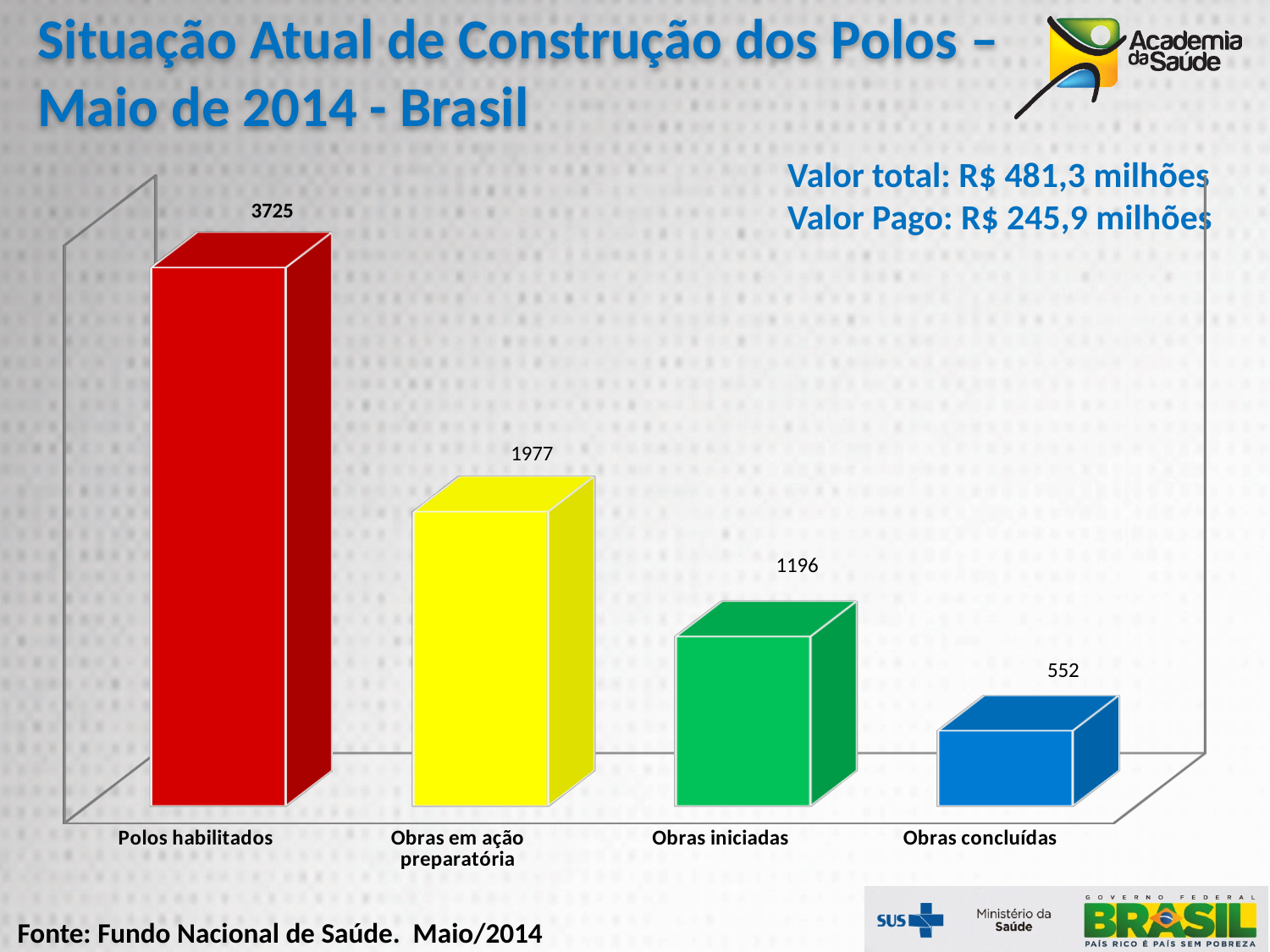
What is the difference between the values for Obras iniciadas and Obras concluídas? 644 What is the value for Obras iniciadas? 1196 Which is larger, the value for Obras em ação preparatória or the value for Obras iniciadas? Obras em ação preparatória What is the value for Obras concluídas? 552 What is the value for Obras em ação preparatória? 1977 What is the value for Polos habilitados? 3725 What kind of chart is shown on the slide? Bar chart How many categories are shown in the chart? 4 Which category has the lowest value? Obras concluídas Which category has the highest value? Polos habilitados What is the difference between the values for Polos habilitados and Obras em ação preparatória? 1748 Do the values rise or fall from left to right along the x axis? Fall